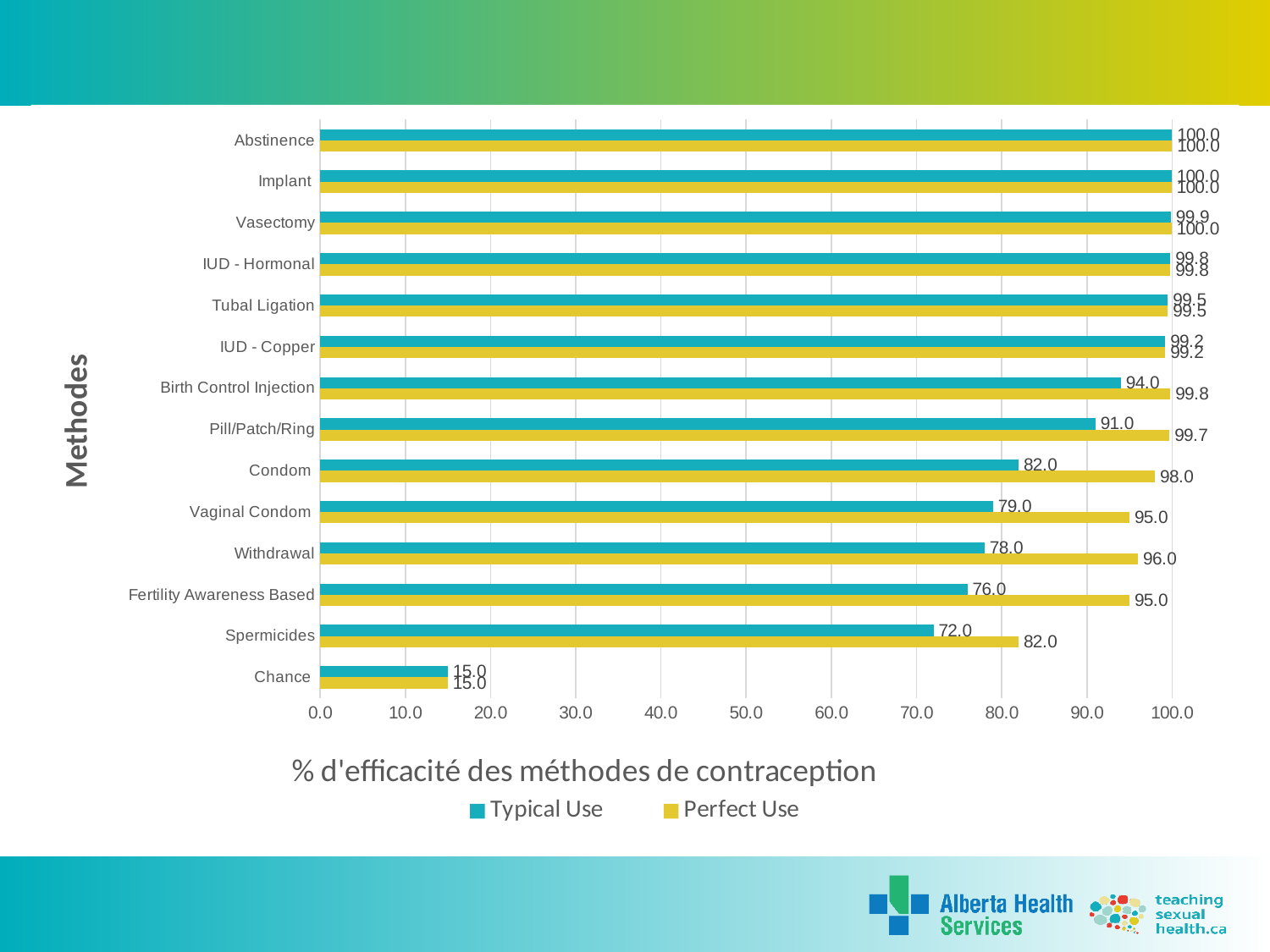
What kind of chart is shown on the slide? bar chart What is the Typical Use value for Condom? 82.0 How many series does the legend list? 2 What is the difference between the Perfect Use and Typical Use values for Pill/Patch/Ring? 8.7 Which is larger, the Typical Use value for Vaginal Condom or the Typical Use value for Spermicides? Vaginal Condom How many contraception methods are listed on the chart? 14 What is the difference between the Perfect Use and Typical Use values for Fertility Awareness Based? 19.0 What is the Perfect Use value for Spermicides? 82.0 What is the Typical Use value for Birth Control Injection? 94.0 Which method has the lowest Typical Use value? Chance What is the Perfect Use value for Withdrawal? 96.0 What is the title shown below the x axis of the chart? % d'efficacité des méthodes de contraception